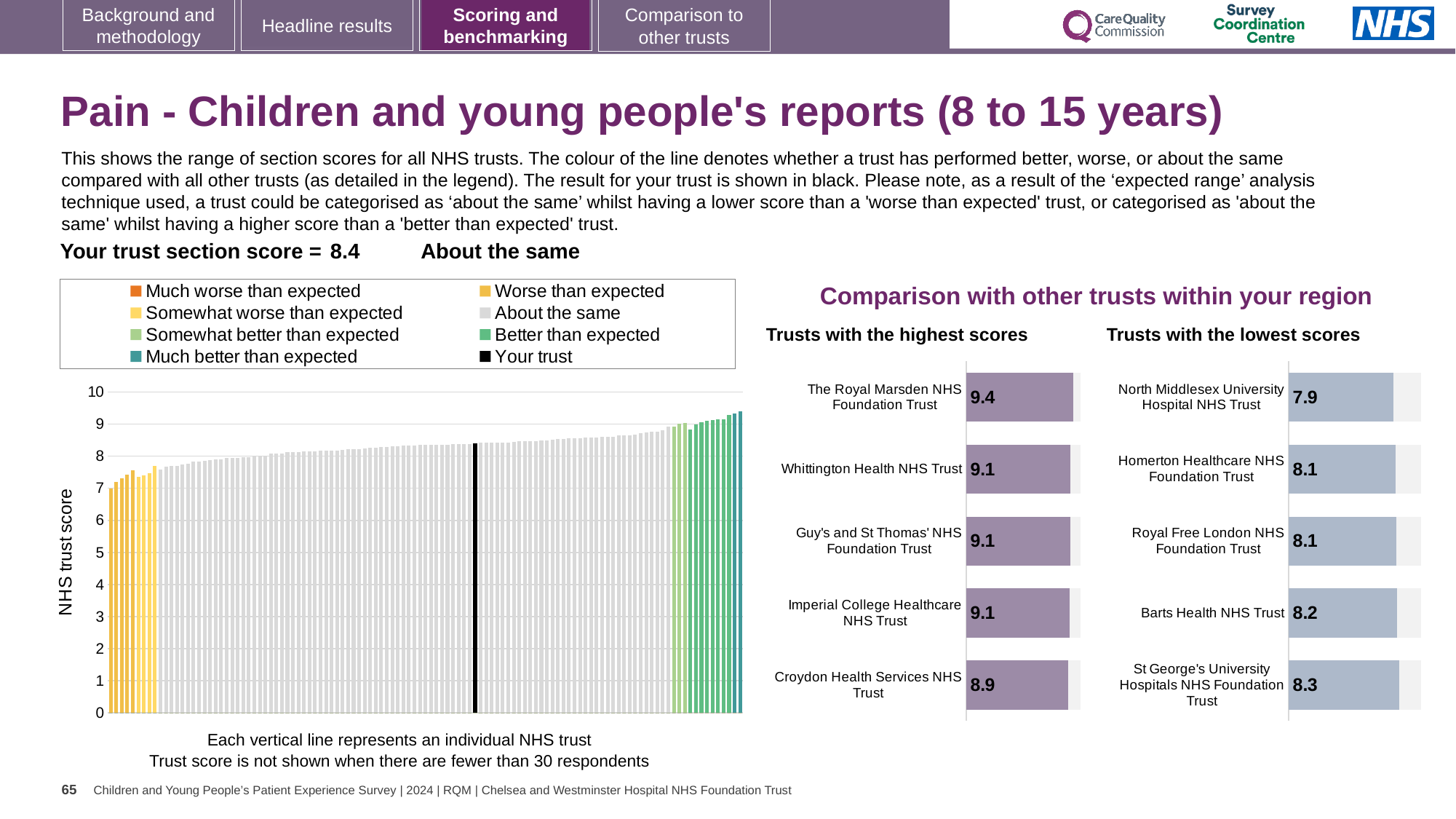
Which is larger: the score for Whittington Health NHS Trust in the highest scores chart or the score for Homerton Healthcare NHS Foundation Trust in the lowest scores chart? Whittington Health NHS Trust In the 'Trusts with the lowest scores' chart, what is the difference between the scores of St George's University Hospitals NHS Foundation Trust and North Middlesex University Hospital NHS Trust? 0.4 In the 'Trusts with the highest scores' chart, which trust has the highest score? The Royal Marsden NHS Foundation Trust How many entries does the legend of the main chart on the left list? 8 In the 'Trusts with the lowest scores' chart, what is the score for North Middlesex University Hospital NHS Trust? 7.9 In the 'Trusts with the highest scores' chart, what is the score for Croydon Health Services NHS Trust? 8.9 In the 'Trusts with the highest scores' chart, what is the score for The Royal Marsden NHS Foundation Trust? 9.4 In the 'Trusts with the lowest scores' chart, what is the score for Barts Health NHS Trust? 8.2 In the main chart on the left showing the range of section scores, what is the score for your trust (the black line)? 8.4 In the 'Trusts with the highest scores' chart, what is the difference between the scores of The Royal Marsden NHS Foundation Trust and Croydon Health Services NHS Trust? 0.5 How many trusts are shown in the 'Trusts with the lowest scores' chart? 5 In the 'Trusts with the lowest scores' chart, which trust has the lowest score? North Middlesex University Hospital NHS Trust